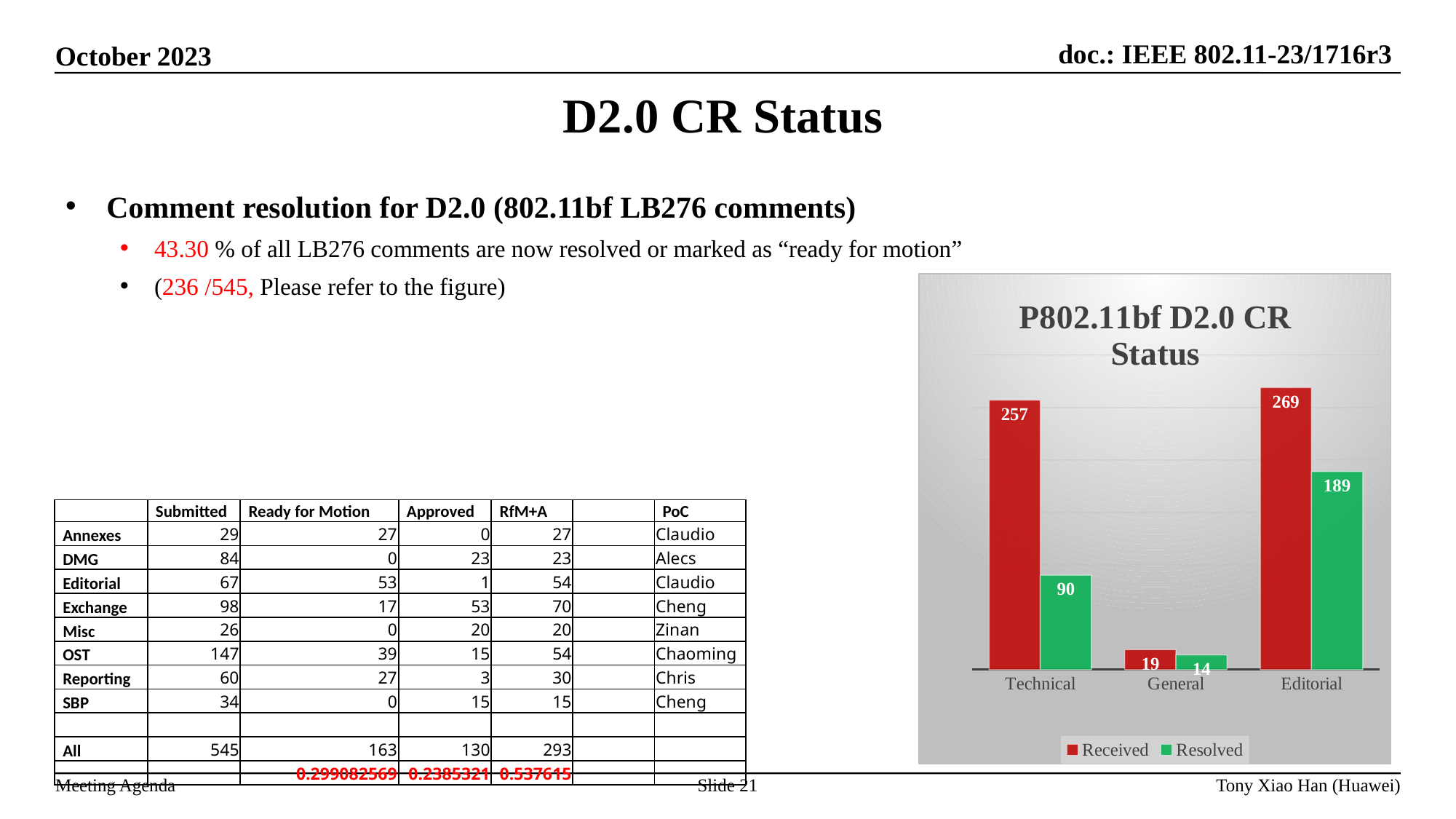
What kind of chart is shown? bar chart Which category has the highest Received value? Editorial What is the difference between the Received values for Editorial and Technical? 12 How many categories are shown on the x axis? 3 Which category has the lowest Resolved value? General How many series does the legend list? 2 What is the Received value for Technical? 257 What is the Resolved value for Editorial? 189 What is the title of the chart? P802.11bf D2.0 CR Status Which is larger, the Resolved value for Technical or the Resolved value for Editorial? Editorial What is the difference between Received and Resolved for Technical? 167 What is the Resolved value for General? 14